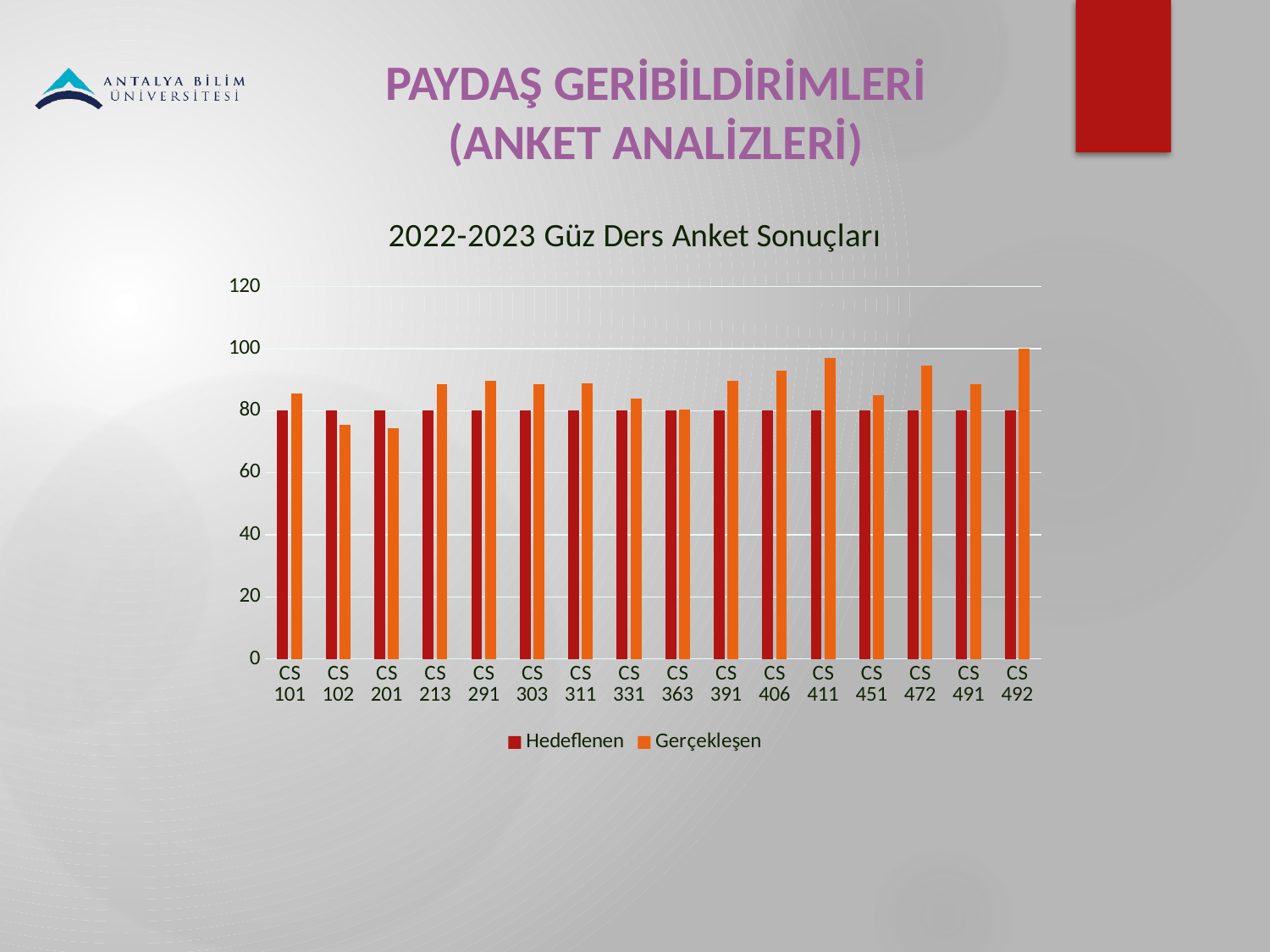
Which is larger, the Gerçekleşen value for CS 411 or for CS 201? CS 411 What is the title of the chart? 2022-2023 Güz Ders Anket Sonuçları Is the Gerçekleşen value for CS 102 greater or less than 80? less What are the two series named in the legend? Hedeflenen and Gerçekleşen How many courses (categories) are shown on the x axis? 16 What is the Hedeflenen value for CS 101? 80 Is the Gerçekleşen value for CS 411 greater or less than 80? greater For CS 201, which is larger, Hedeflenen or Gerçekleşen? Hedeflenen What is the Gerçekleşen value for CS 492? 100 What kind of chart is shown on the slide? bar chart How many series does the legend list? 2 Which course has the highest Gerçekleşen value? CS 492